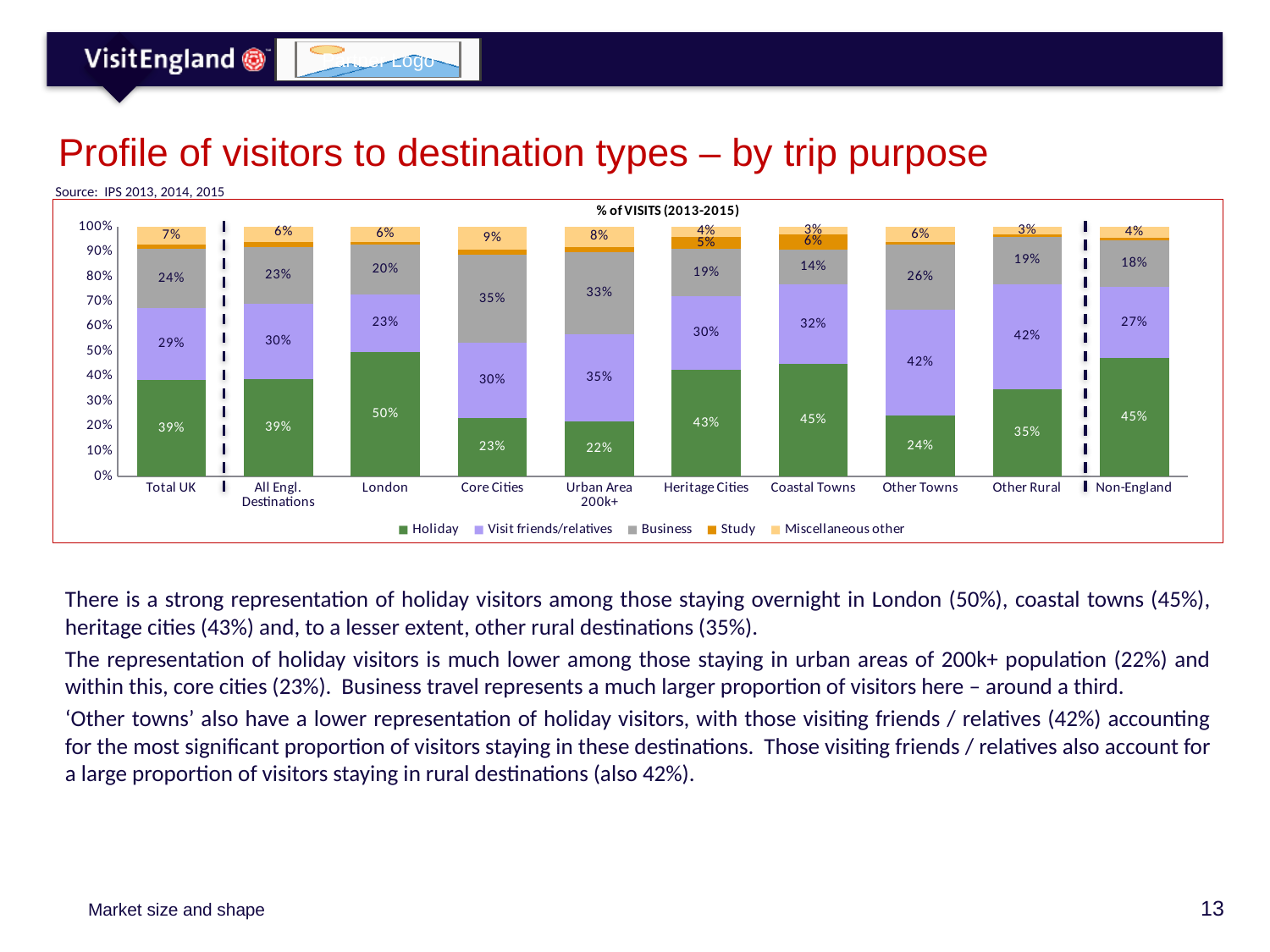
What kind of chart is shown on the slide? Stacked bar chart How many percentage points higher is the Holiday share for London than for Core Cities? 27 percentage points Which destination type has the highest Business share of visits? Core Cities Which has a larger Visit friends/relatives share: Other Towns or London? Other Towns Which destination type has the highest Holiday share of visits? London Which destination type has the lowest Holiday share of visits? Urban Area 200k+ What is the Miscellaneous other share of visits for Core Cities? 9% What is the Study share of visits for Coastal Towns? 6% How many destination categories are shown on the x axis? 10 How many series does the legend list? 5 What percentage of visits to London are for Holiday? 50% What is the Business share of visits for Core Cities? 35%